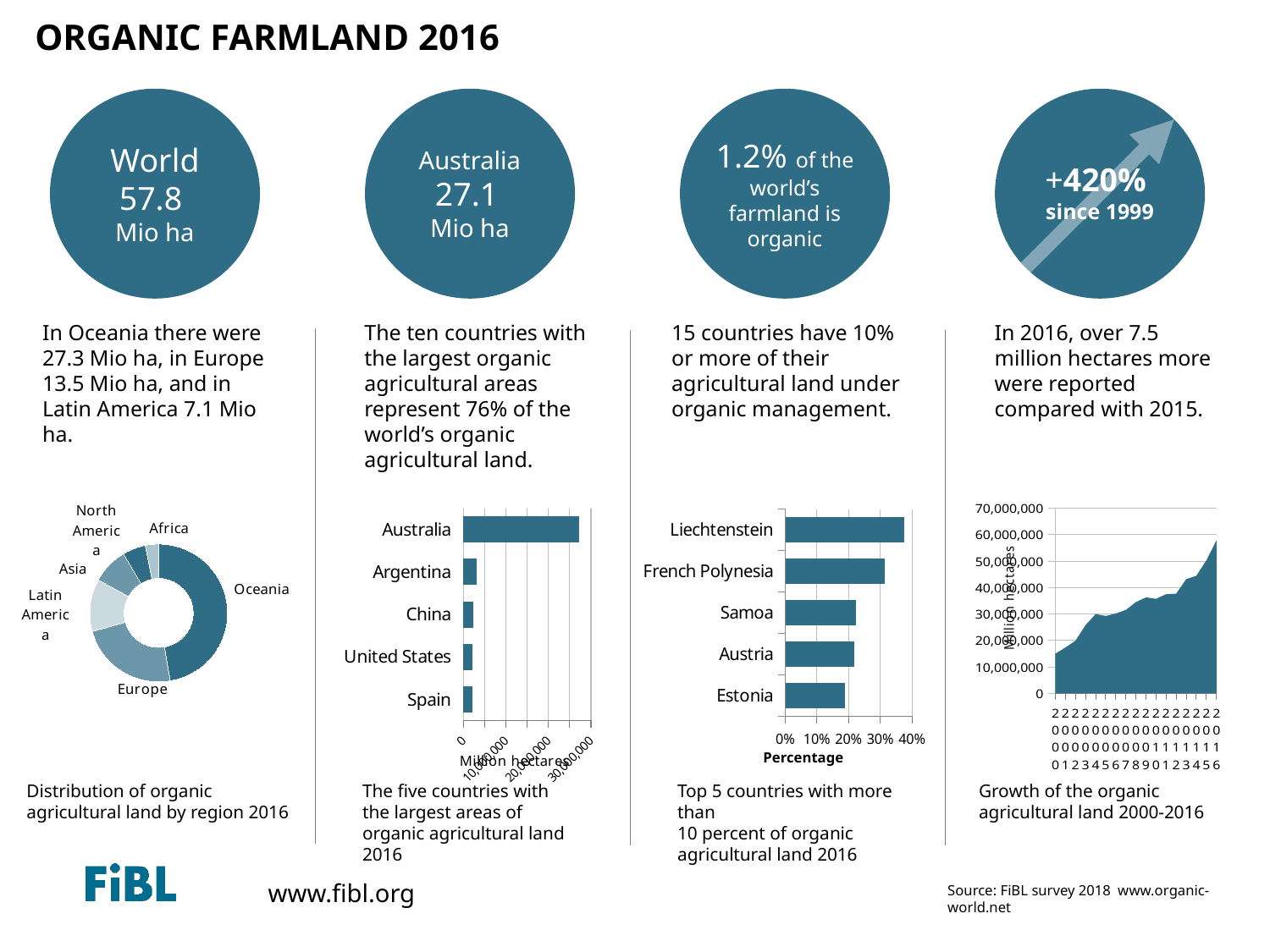
In 'Growth of the organic agricultural land 2000-2016', do the values generally rise or fall from 2000 to 2016? rise In 'Top 5 countries with more than 10 percent of organic agricultural land 2016', which country has the lowest percentage? Estonia In 'The five countries with the largest areas of organic agricultural land 2016', which country has the largest area? Australia In 'Top 5 countries with more than 10 percent of organic agricultural land 2016', which country has the highest percentage? Liechtenstein In 'The five countries with the largest areas of organic agricultural land 2016', is the value for Australia greater or less than 30,000,000? less What kind of chart is 'Distribution of organic agricultural land by region 2016'? doughnut chart In 'The five countries with the largest areas of organic agricultural land 2016', how many countries are shown? 5 What kind of chart is 'Growth of the organic agricultural land 2000-2016'? area chart In 'Top 5 countries with more than 10 percent of organic agricultural land 2016', is the value for Liechtenstein greater or less than 30%? greater What kind of chart is 'The five countries with the largest areas of organic agricultural land 2016'? bar chart In 'Top 5 countries with more than 10 percent of organic agricultural land 2016', which has the larger value, Liechtenstein or French Polynesia? Liechtenstein In 'Distribution of organic agricultural land by region 2016', which region has the largest slice? Oceania